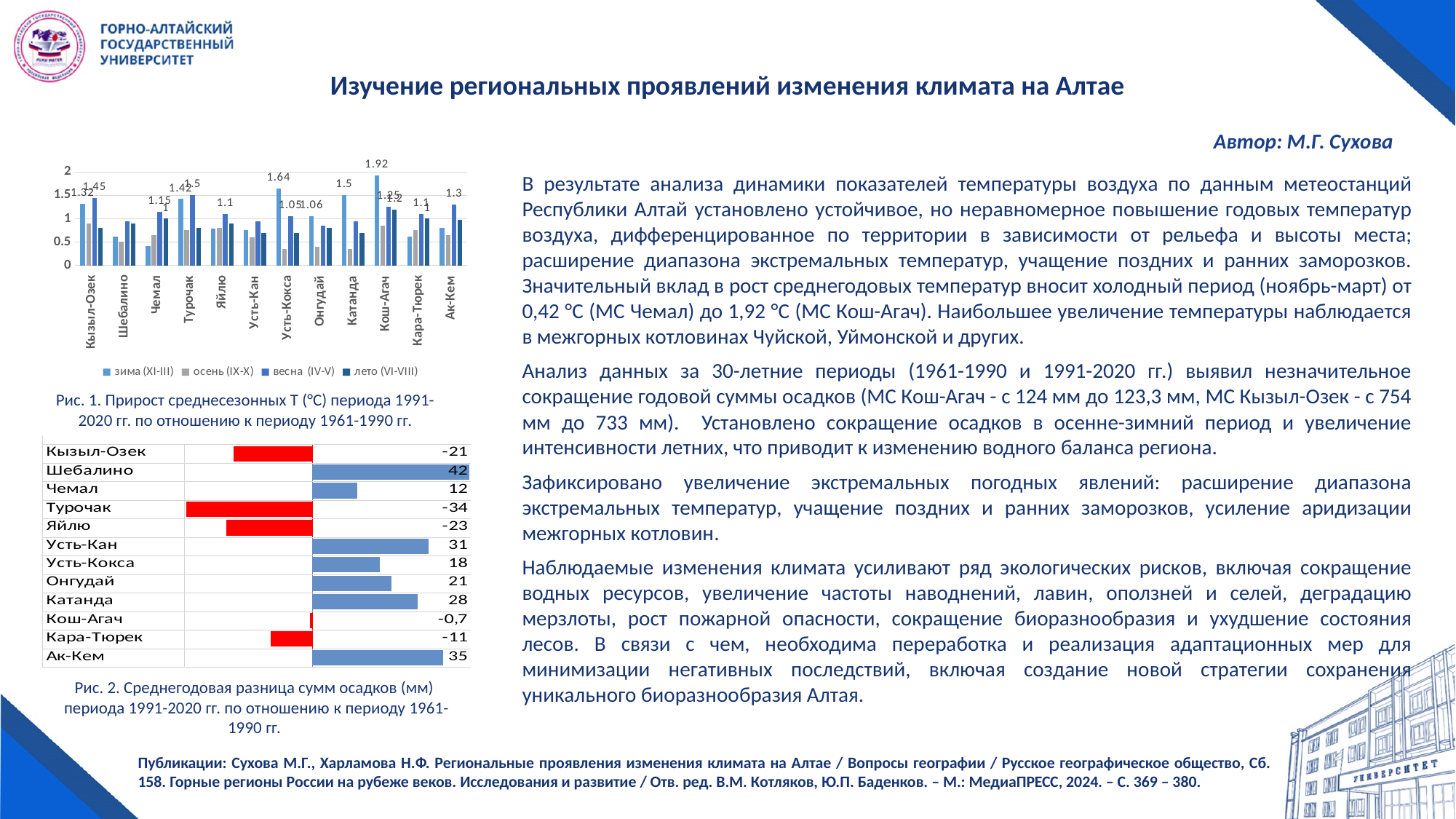
In Рис. 2, which is larger, the value for Усть-Кан or the value for Онгудай? Усть-Кан In Рис. 2, what is the value for Кош-Агач? -0,7 In Рис. 2, what is the difference between the values for Ак-Кем and Катанда? 7 What kind of chart is Рис. 2? Bar chart In Рис. 1, what is the value of the зима (XI-III) series for Кош-Агач? 1.92 In Рис. 2, what is the value for Шебалино? 42 In Рис. 2, which station has the lowest value? Турочак In Рис. 1, how many series does the legend list? 4 In Рис. 2, which station has the highest value? Шебалино In Рис. 1, which station has the highest value for the зима (XI-III) series? Кош-Агач In Рис. 2, how many stations are listed? 12 In Рис. 2, what is the value for Турочак? -34